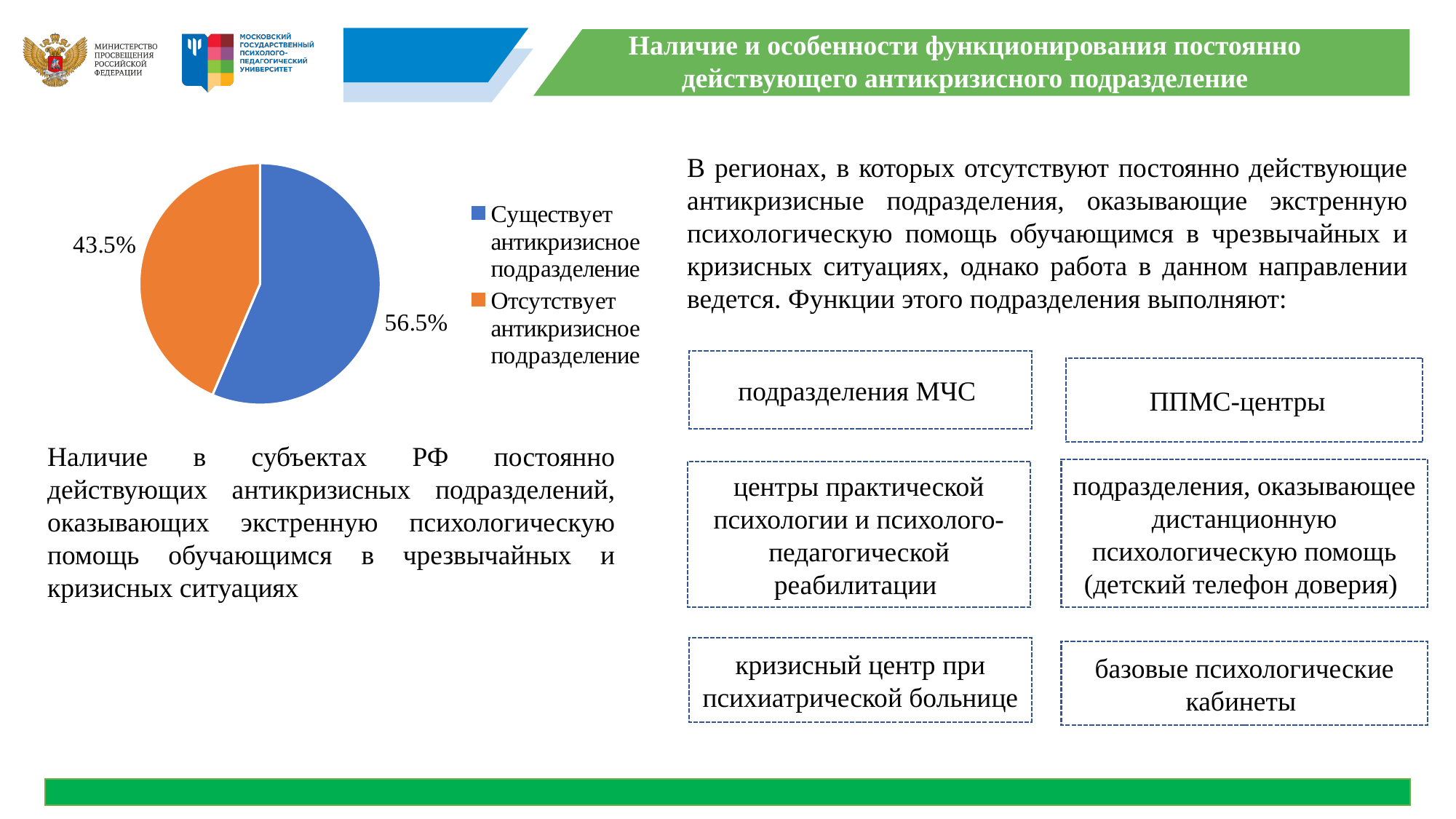
What is the difference in percentage points between the two slices of the pie chart? 13 percentage points Is the share for "Отсутствует антикризисное подразделение" greater or less than 50%? less What colour is the slice for "Существует антикризисное подразделение"? blue What colour is the slice for "Отсутствует антикризисное подразделение"? orange How many slices does the pie chart have? 2 What type of chart is shown on the slide? pie chart What percentage of the pie chart corresponds to "Отсутствует антикризисное подразделение"? 43.5% Which category has the smallest share in the pie chart? Отсутствует антикризисное подразделение What percentage of the pie chart corresponds to "Существует антикризисное подразделение"? 56.5% How many entries does the legend of the pie chart list? 2 Which category has the largest share in the pie chart? Существует антикризисное подразделение Which is larger: the share for "Существует антикризисное подразделение" or for "Отсутствует антикризисное подразделение"? Существует антикризисное подразделение